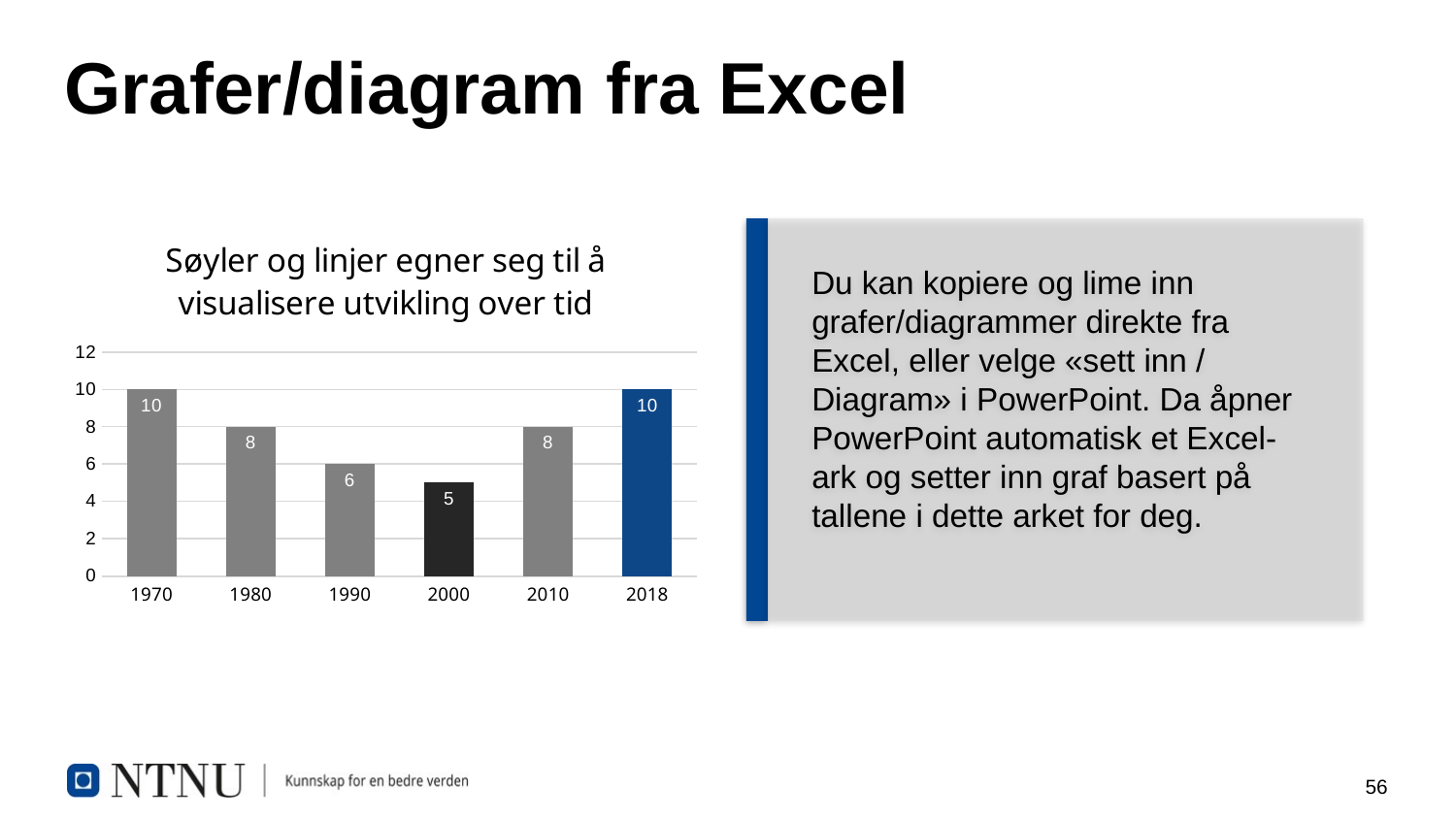
What is the value for 1970? 10 Which category has the lowest value? 2000 What kind of chart is shown? bar chart What is the title of the chart? Søyler og linjer egner seg til å visualisere utvikling over tid What is the difference between the values for 1970 and 1990? 4 Which bar is coloured blue? 2018 Do the values rise or fall from 1970 to 2000? fall Which is larger, the value for 1990 or the value for 2010? 2010 What is the value for 2018? 10 How many categories are shown on the x axis? 6 What is the value for 2000? 5 What is the difference between the values for 1980 and 2000? 3